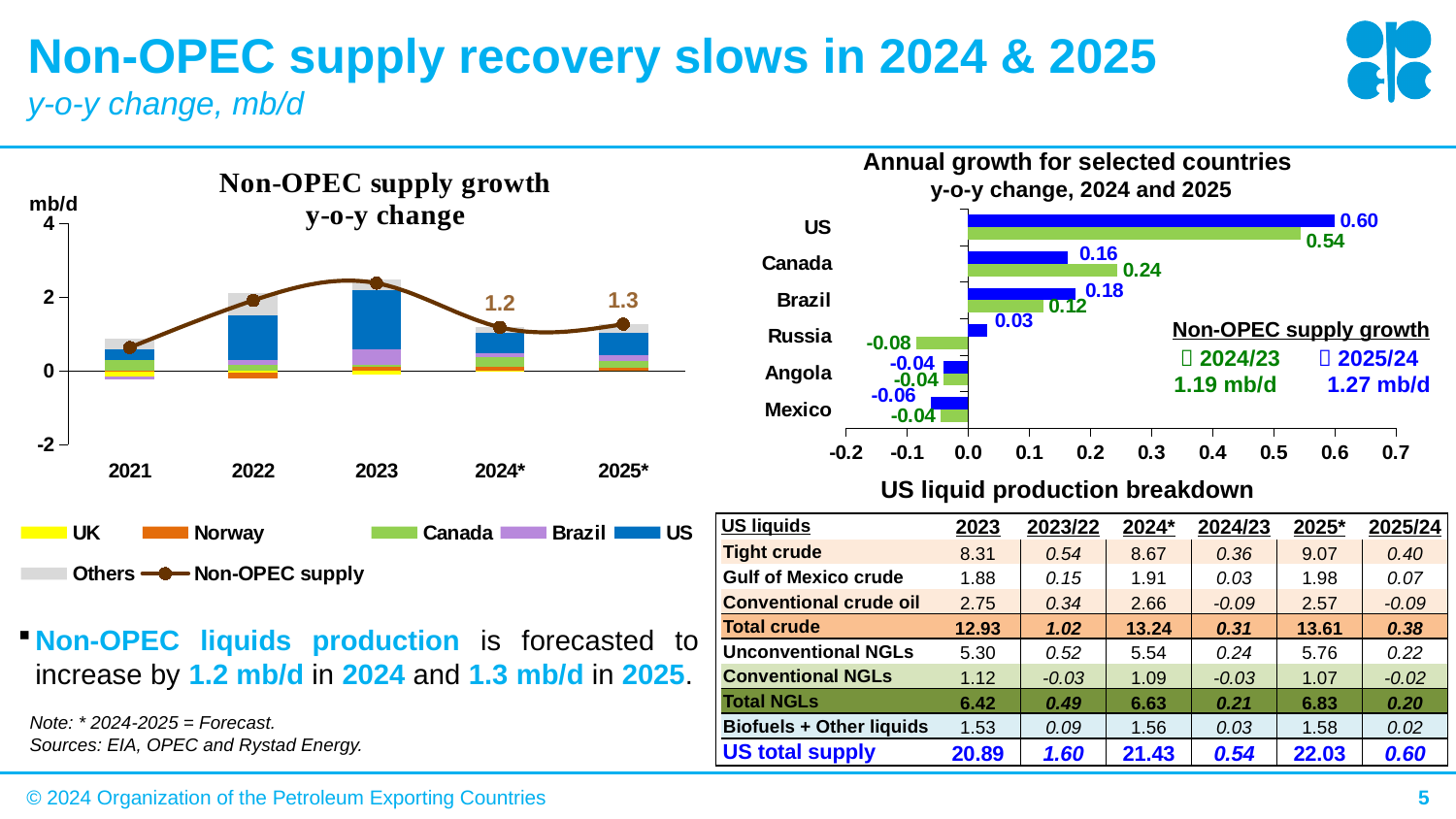
In the 'Annual growth for selected countries' chart, which is larger for 2024/23: Canada or Brazil? Canada In the 'Non-OPEC supply growth y-o-y change' chart, is the Non-OPEC supply value for 2023 greater or less than 2? greater In the 'Annual growth for selected countries' chart, which country has the lowest 2024/23 value? Russia In the 'Annual growth for selected countries' chart, what is the 2025/24 value for the US? 0.60 How many countries are shown in the 'Annual growth for selected countries' chart? 6 In the 'Annual growth for selected countries' chart, which country has the highest 2025/24 value? US In the 'Annual growth for selected countries' chart, what is the 2024/23 value for Canada? 0.24 How many years are shown on the x axis of the 'Non-OPEC supply growth y-o-y change' chart? 5 In the 'Non-OPEC supply growth y-o-y change' chart, what is the Non-OPEC supply value for 2024*? 1.2 What kind of chart is the 'Annual growth for selected countries' chart? Bar chart In the 'Annual growth for selected countries' chart, what is the difference between the US 2025/24 value and its 2024/23 value? 0.06